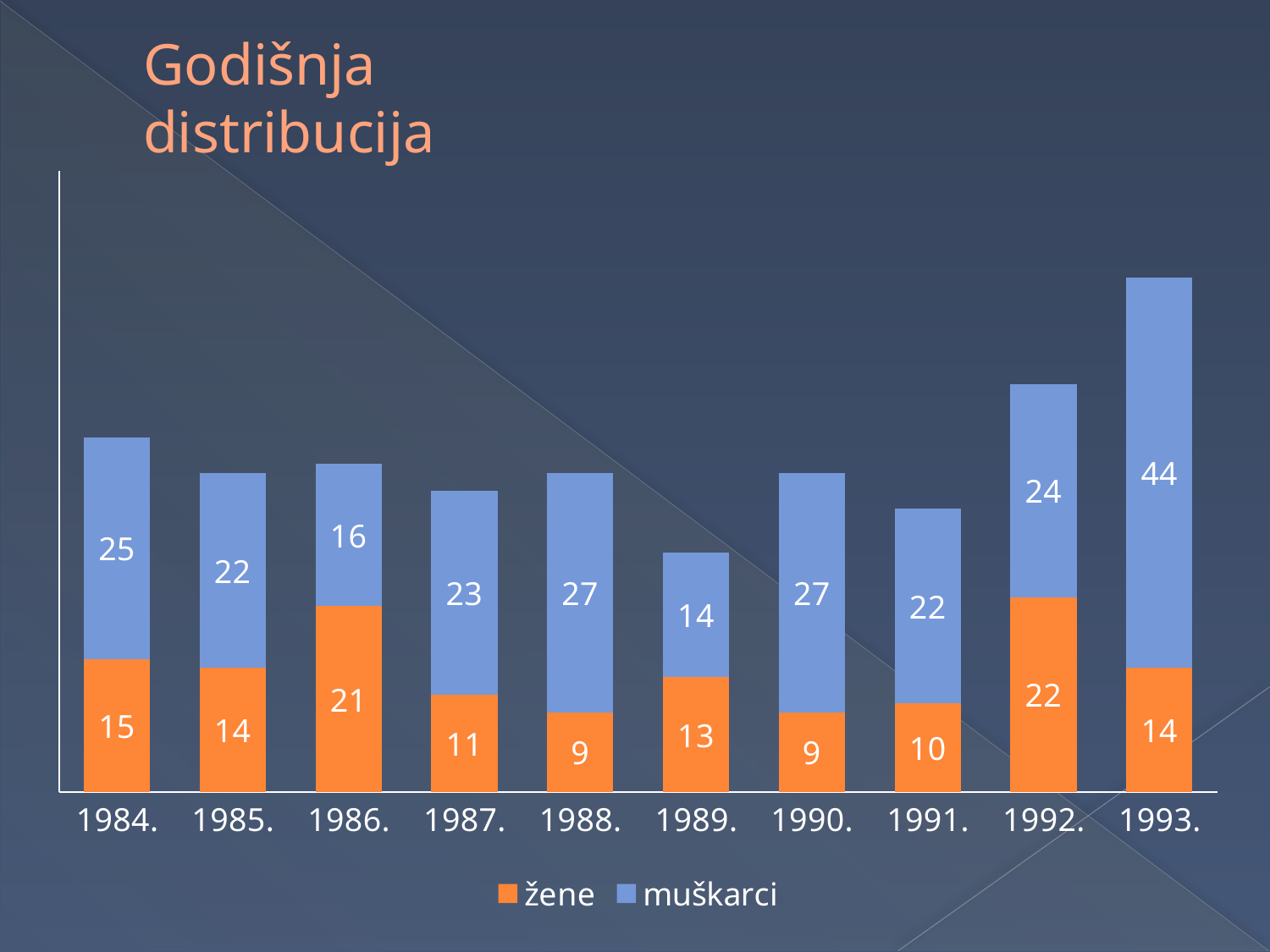
Which year has the lowest value for žene? 1988. and 1990. What is the value for muškarci in 1989.? 14 Which year has the highest value for muškarci? 1993. What is the total of the stacked bar for 1992.? 46 What kind of chart is shown on the slide? stacked bar chart How many series does the legend list? 2 What is the value for muškarci in 1993.? 44 Which is larger in 1986., the value for žene or the value for muškarci? žene What is the difference between the muškarci value and the žene value in 1993.? 30 What is the value for žene in 1986.? 21 What is the title of the chart? Godišnja distribucija How many years are shown on the x axis? 10